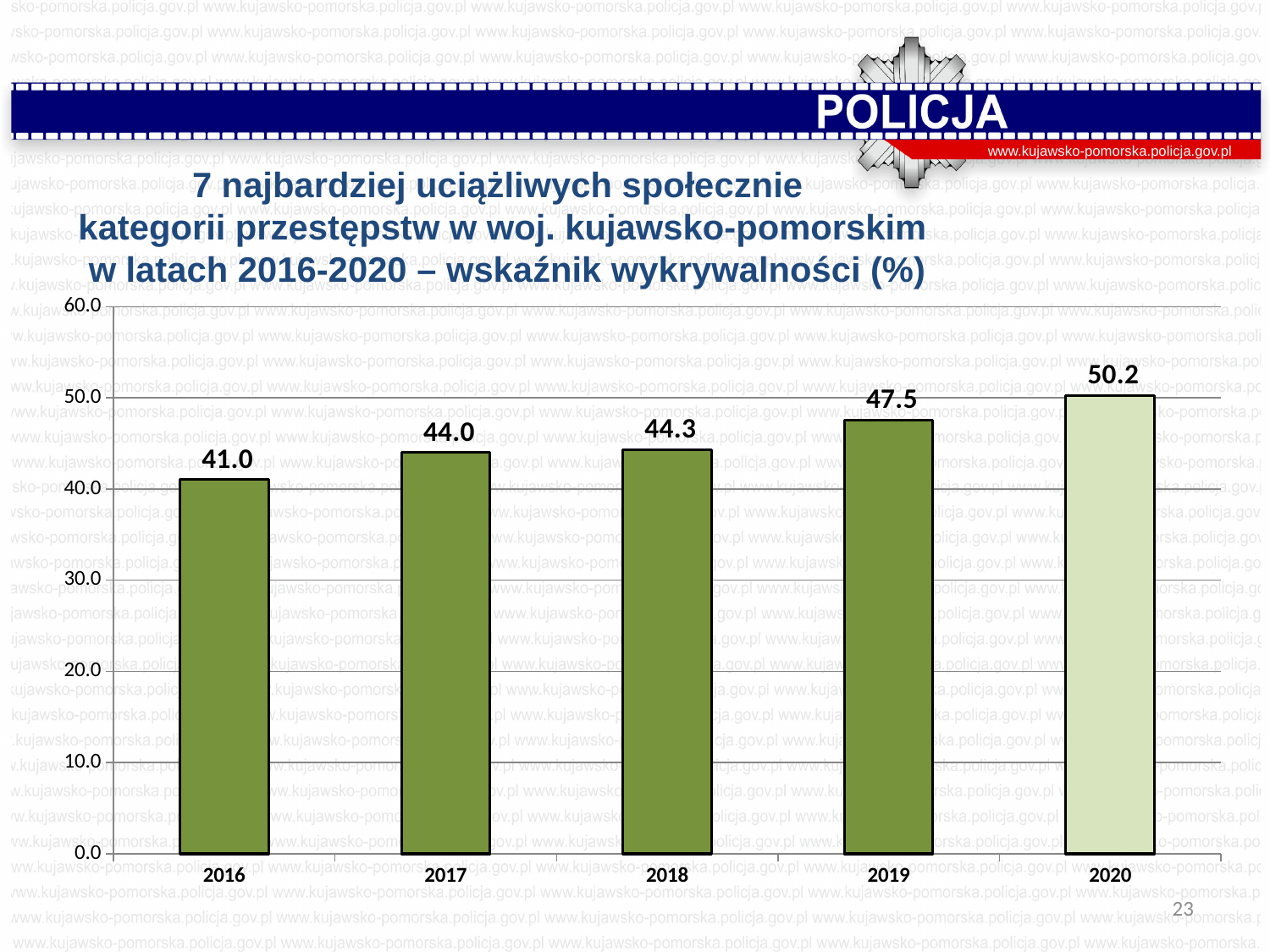
What kind of chart is shown on the slide? bar chart Which year has the lowest value? 2016 What is the value shown for 2019? 47.5 Which year has the highest value? 2020 What is the difference between the values for 2020 and 2016? 9.2 Is the value for 2020 greater or less than 50.0? greater What is the value shown for 2020? 50.2 What is the difference between the values for 2019 and 2018? 3.2 How many years are shown on the chart? 5 What is the detection rate value shown for 2016? 41.0 Do the values rise or fall from 2016 to 2020? rise Which is larger, the value for 2017 or the value for 2019? 2019